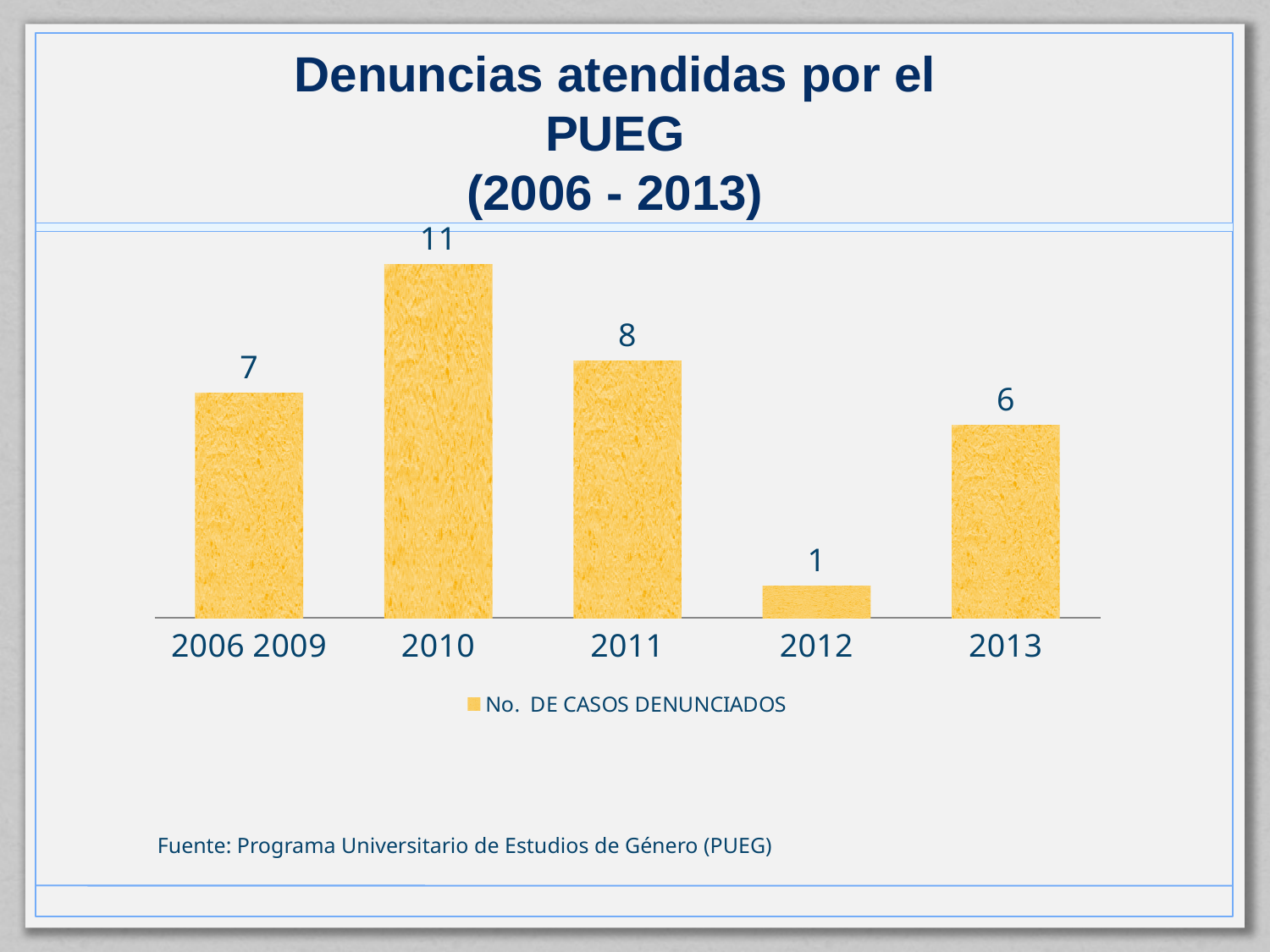
What is the legend entry for the series? No. DE CASOS DENUNCIADOS What is the difference between the values for 2010 and 2011? 3 How many categories are shown on the x axis? 5 What is the value for 2012? 1 What kind of chart is shown? bar chart Which category has the highest value? 2010 Which category has the lowest value? 2012 What is the value for the 2006 2009 category? 7 What is the value for 2010? 11 What is the value for 2013? 6 How many series does the legend list? 1 Which is larger, the value for 2011 or the value for 2013? 2011